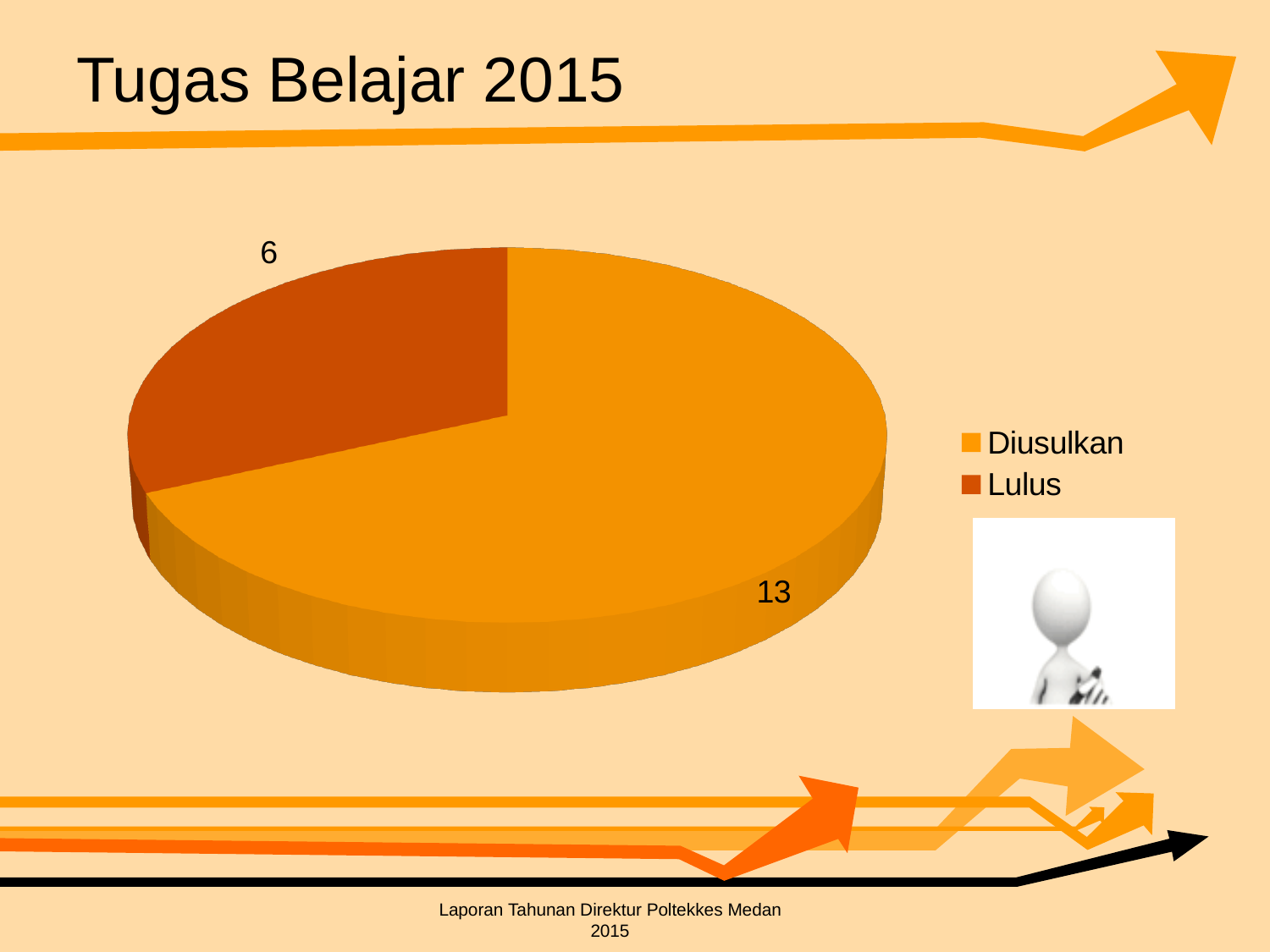
Which category has the largest slice in the pie chart? Diusulkan How many slices does the pie chart have? 2 What is the value for Diusulkan in the pie chart? 13 What is the title of the slide containing the pie chart? Tugas Belajar 2015 Which category has the smallest slice in the pie chart? Lulus What kind of chart is shown on the slide? pie chart Which is larger, the value for Diusulkan or the value for Lulus? Diusulkan What is the total of all slices in the pie chart? 19 What is the value for Lulus in the pie chart? 6 How many entries does the legend list? 2 What is the difference between the values for Diusulkan and Lulus? 7